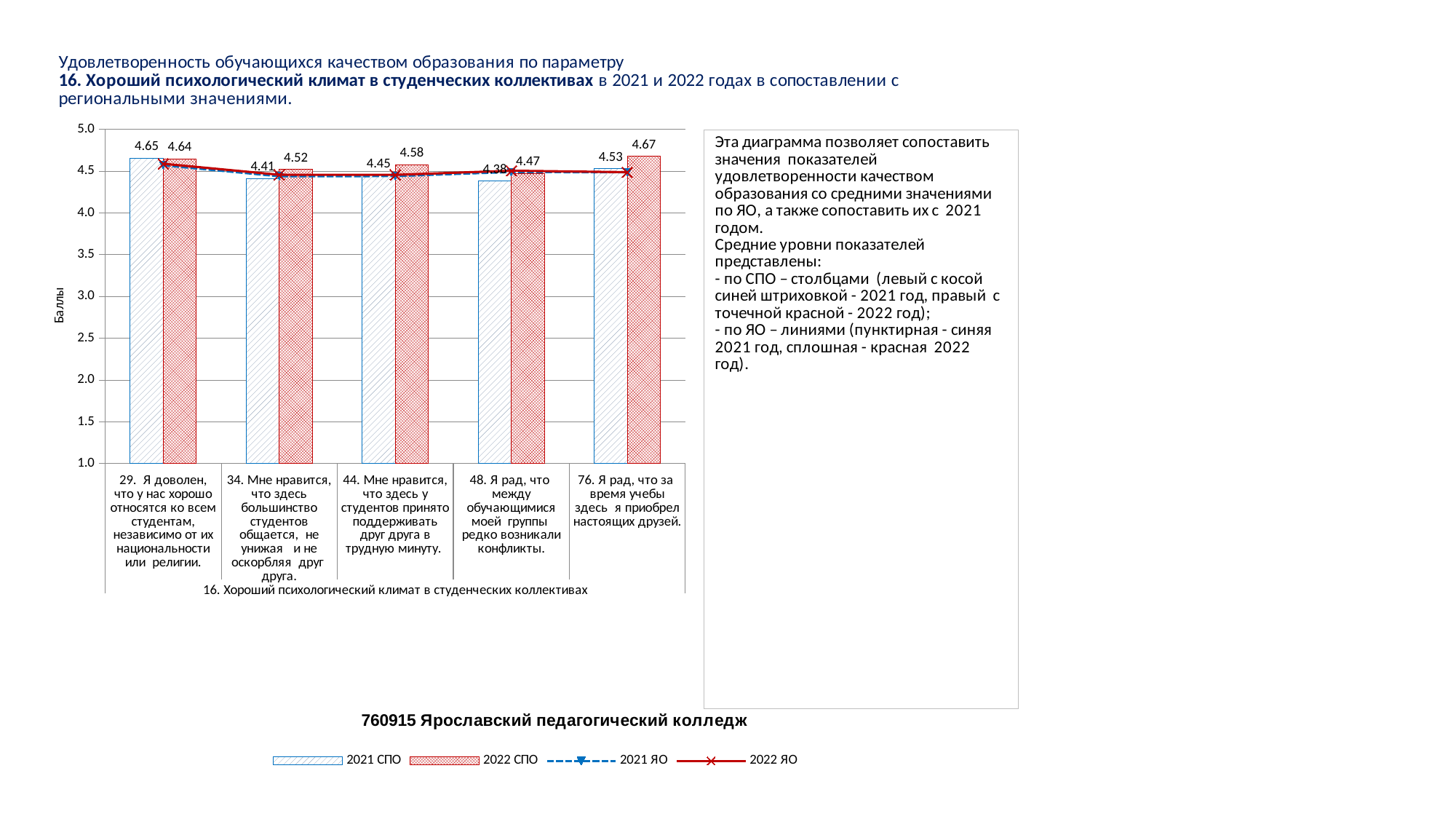
What is the difference between the 2022 СПО and 2021 СПО values for item 34? 0.11 Which item has the highest 2022 СПО value? 76. Я рад, что за время учебы здесь я приобрел настоящих друзей. What is the 2022 СПО value for item 76 ("Я рад, что за время учебы здесь я приобрел настоящих друзей")? 4.67 For item 48, which is larger: the 2021 СПО value or the 2022 СПО value? 2022 СПО Which item has the lowest 2021 СПО value? 48. Я рад, что между обучающимися моей группы редко возникали конфликты. How many series does the legend list? 4 What is the 2022 СПО value for item 44 ("Мне нравится, что здесь у студентов принято поддерживать друг друга в трудную минуту")? 4.58 What is the difference between the 2022 СПО and 2021 СПО values for item 76? 0.14 How many items (categories) are shown on the x axis? 5 What is the label of the vertical axis? Баллы What is the 2021 СПО value for item 29 ("Я доволен, что у нас хорошо относятся ко всем студентам...")? 4.65 Is the 2021 СПО value for item 48 greater or less than 4.5? less